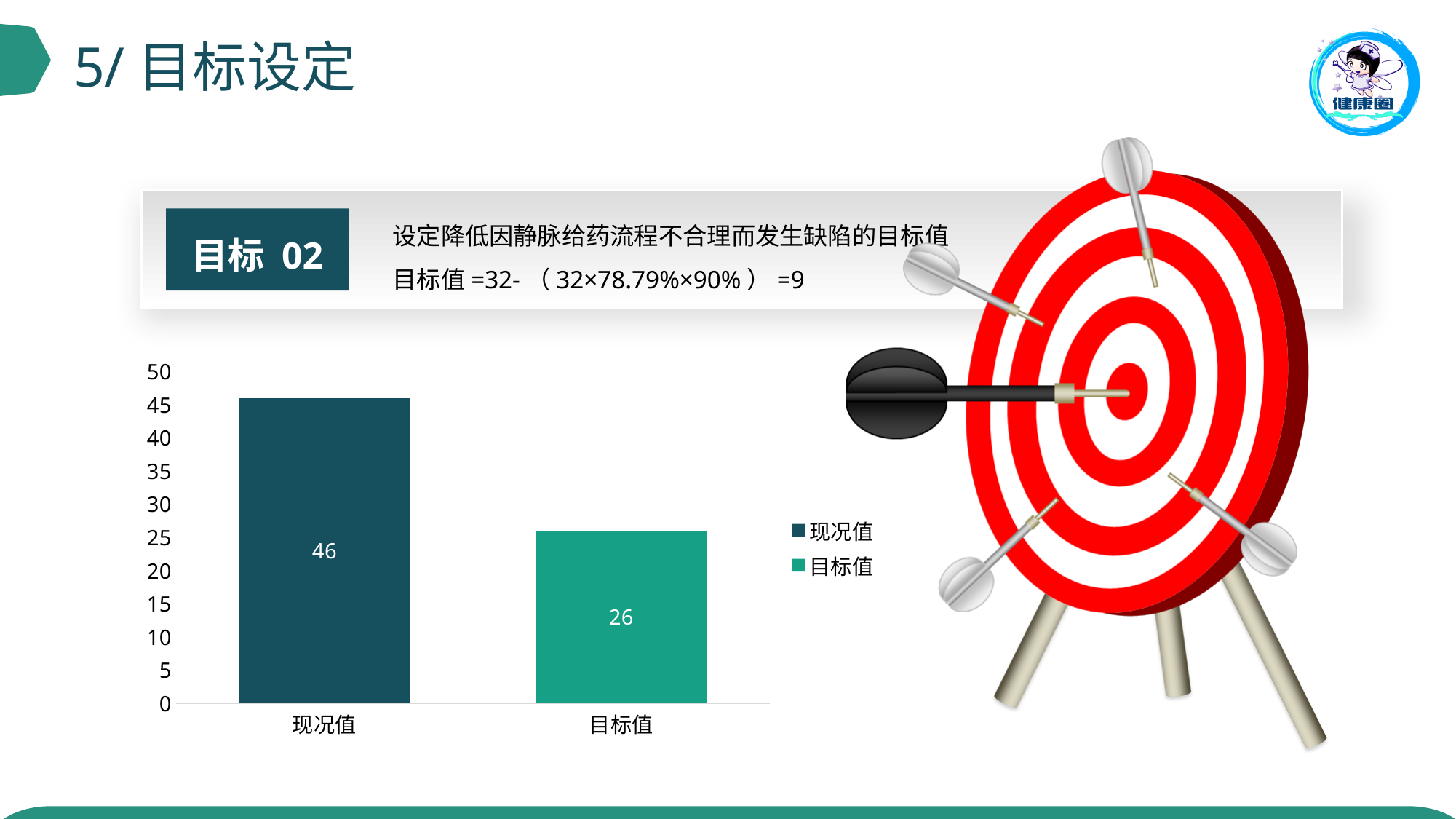
How many categories are shown on the x axis? 2 Is the value for 目标值 greater or less than 30? less What is the value for 现况值? 46 What is the maximum value shown on the y axis? 50 Which category has the highest value? 现况值 What kind of chart is shown on the slide? bar chart Which category has the lowest value? 目标值 Is the value for 现况值 greater or less than 40? greater What is the difference between the values for 现况值 and 目标值? 20 How many entries does the legend list? 2 Which is larger, the value for 现况值 or the value for 目标值? 现况值 What is the value for 目标值? 26